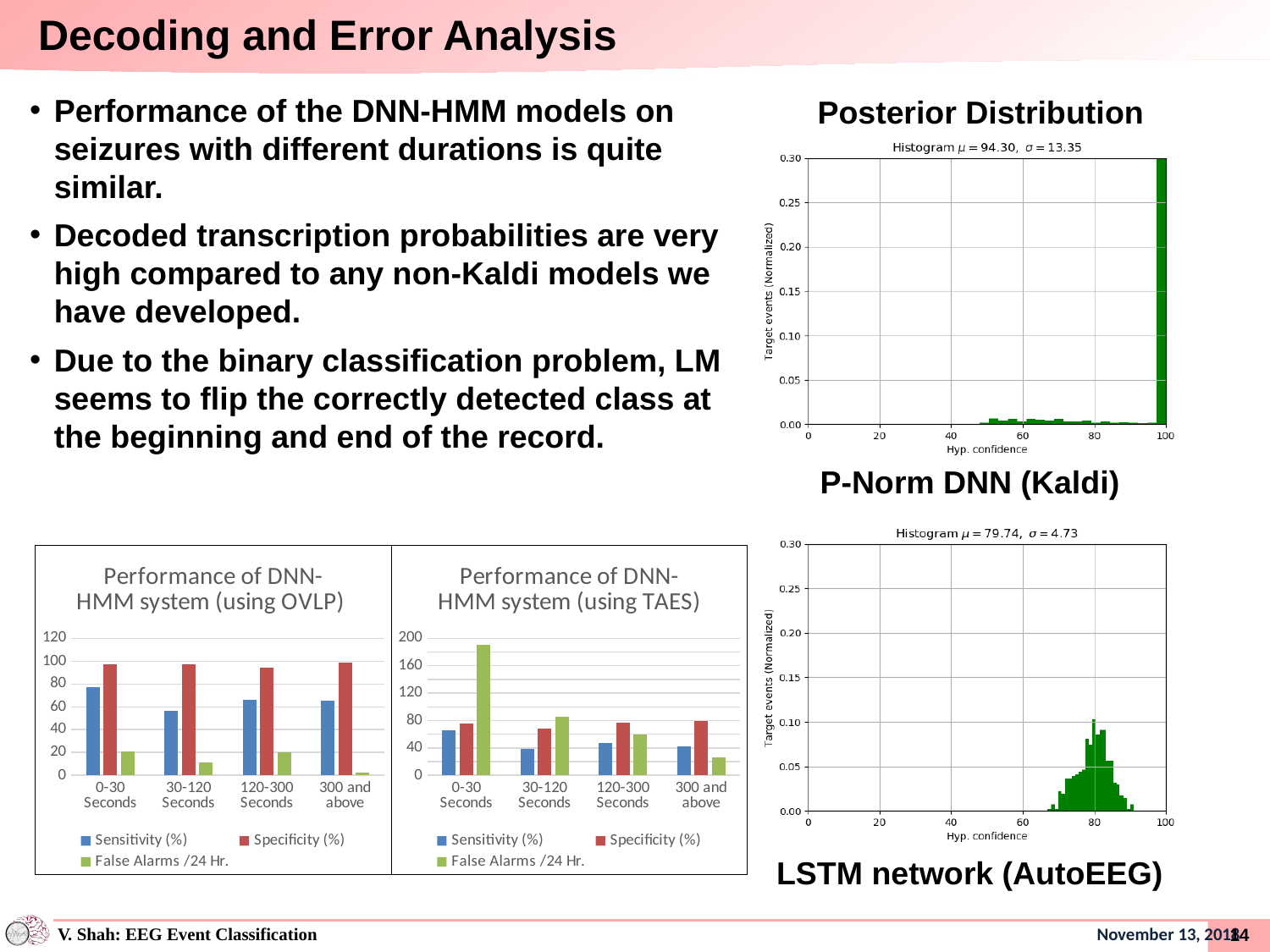
In "Performance of DNN-HMM system (using TAES)", which is larger for 0-30 Seconds: Sensitivity (%) or False Alarms /24 Hr.? False Alarms /24 Hr. How many series does the legend of "Performance of DNN-HMM system (using TAES)" list? 3 What kind of chart is "Performance of DNN-HMM system (using OVLP)"? bar chart In "Performance of DNN-HMM system (using OVLP)", which category has the lowest False Alarms /24 Hr.? 300 and above How many duration categories are shown on the x axis of "Performance of DNN-HMM system (using OVLP)"? 4 In "Performance of DNN-HMM system (using OVLP)", is the Specificity (%) for 0-30 Seconds greater or less than 80? greater In "Performance of DNN-HMM system (using TAES)", is the False Alarms /24 Hr. value for 0-30 Seconds greater or less than 160? greater In "Performance of DNN-HMM system (using OVLP)", is the Sensitivity (%) for 30-120 Seconds greater or less than 60? less What is the mean (μ) printed in the title of the P-Norm DNN (Kaldi) histogram? 94.30 In "Performance of DNN-HMM system (using TAES)", does the False Alarms /24 Hr. series rise or fall across the categories from 0-30 Seconds to 300 and above? fall In "Performance of DNN-HMM system (using TAES)", which category has the highest False Alarms /24 Hr.? 0-30 Seconds What is the standard deviation (σ) printed in the title of the LSTM network (AutoEEG) histogram? 4.73